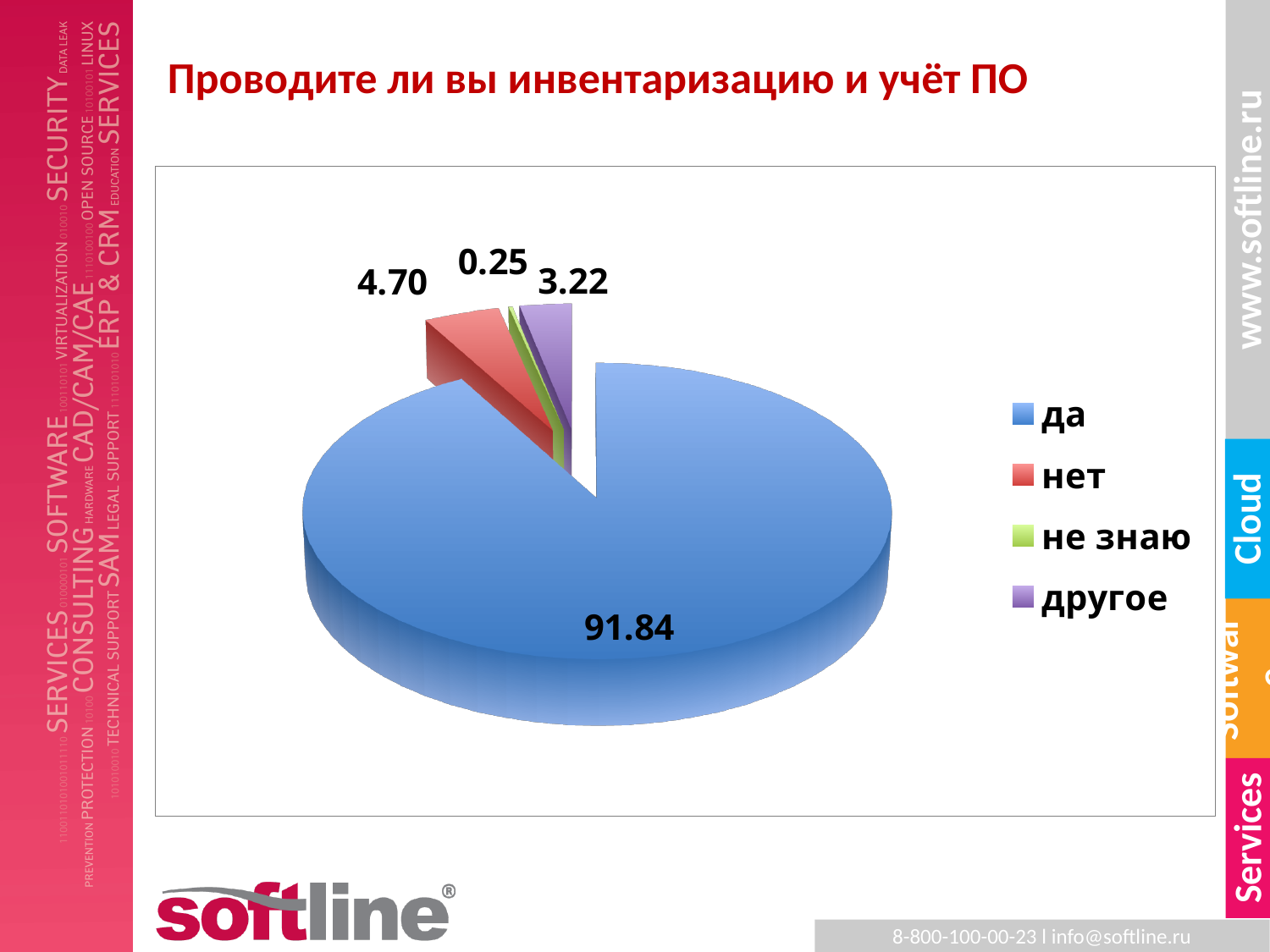
Which category has the largest slice? да What is the difference between the values for "нет" and "другое"? 1.48 What is the value for "да"? 91.84 What is the title of the slide? Проводите ли вы инвентаризацию и учёт ПО Which category has the smallest slice? не знаю What kind of chart is shown on the slide? pie chart What is the value for "другое"? 3.22 What is the value for "не знаю"? 0.25 Which is larger, the value for "нет" or the value for "другое"? нет What is the value for "нет"? 4.70 What colour is the slice for "да"? blue How many categories does the pie chart have? 4